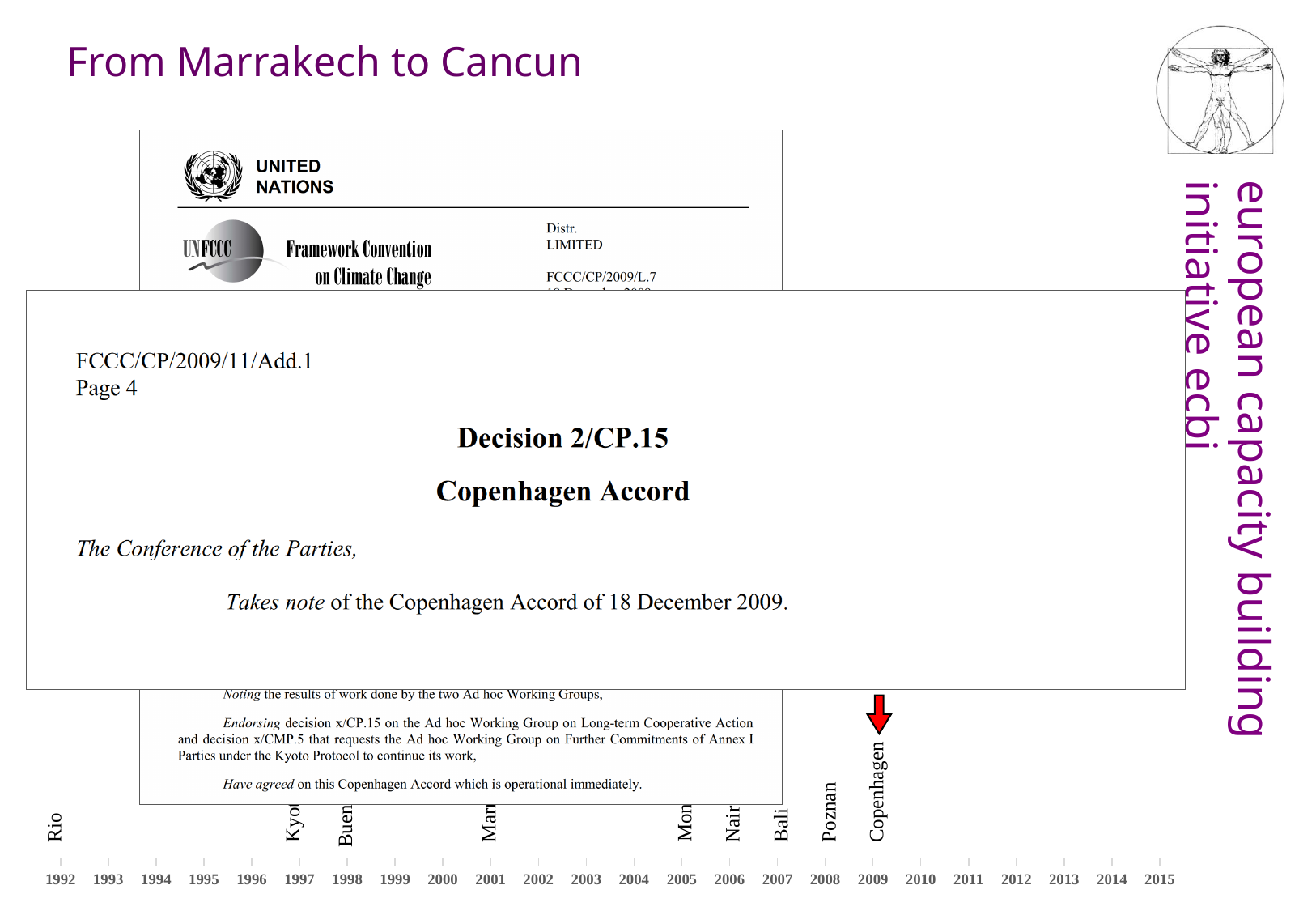
What is the last year shown on the timeline axis at the bottom of the slide? 2015 On the timeline at the bottom of the slide, which year is Bali placed at? 2007 On the timeline at the bottom of the slide, which year is Copenhagen placed at? 2009 How many years apart are Rio and Copenhagen on the timeline? 17 On the timeline at the bottom of the slide, which year is Poznan placed at? 2008 On the timeline, which event comes later, Bali or Poznan? Poznan Which event on the timeline does the red arrow point to? Copenhagen On the timeline at the bottom of the slide, which year is Rio placed at? 1992 How many year labels are shown on the timeline axis at the bottom of the slide? 24 What is the first year shown on the timeline axis at the bottom of the slide? 1992